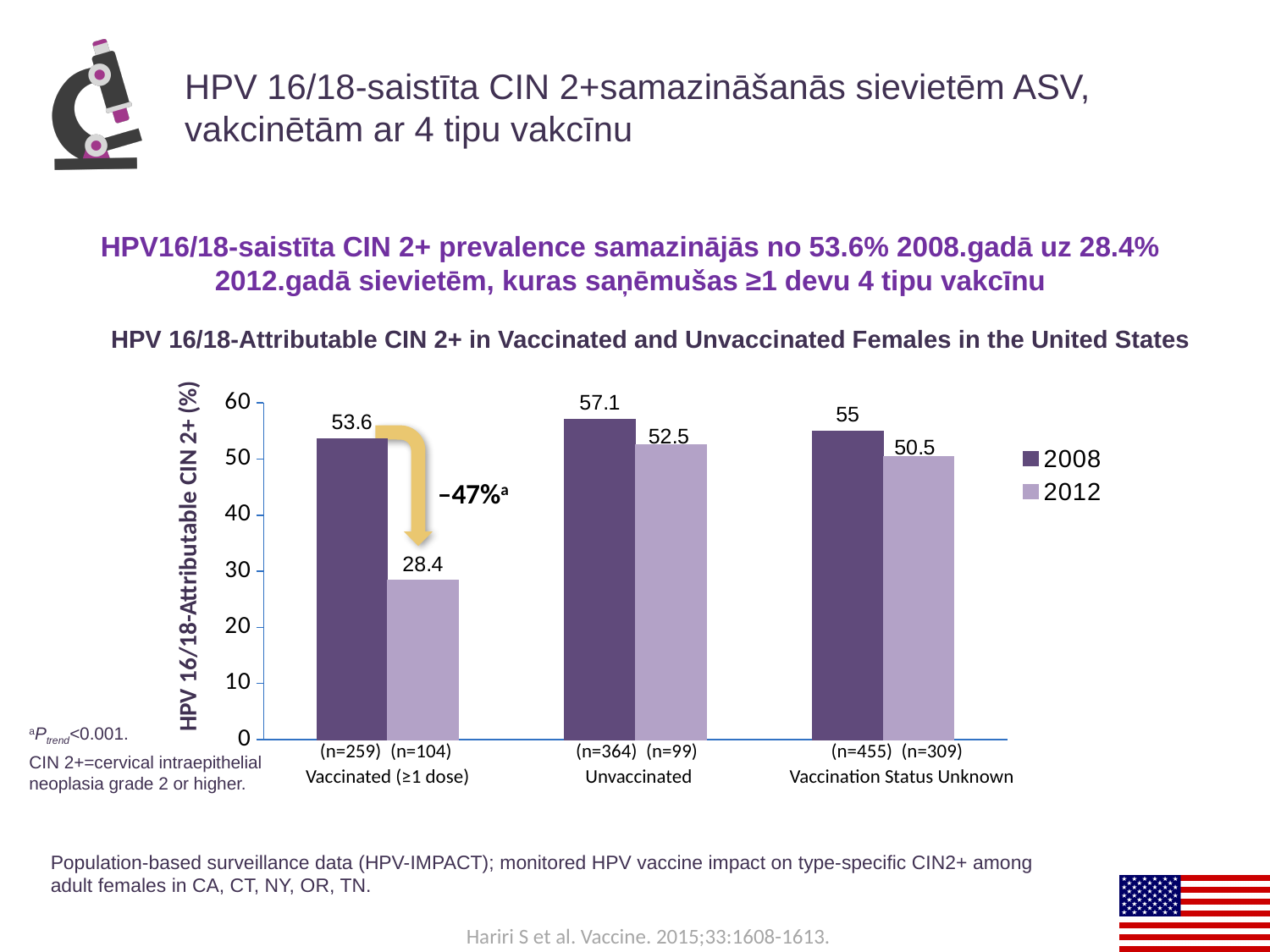
How many groups are shown on the x axis? 3 What is the difference between the 2008 and 2012 values for the Vaccinated (≥1 dose) group? 25.2 Which group has the highest 2008 value? Unvaccinated Which group has the lowest 2012 value? Vaccinated (≥1 dose) Which is larger: the 2012 value for Unvaccinated or the 2012 value for Vaccination Status Unknown? Unvaccinated What is the 2012 value for the Vaccinated (≥1 dose) group? 28.4 What is the 2008 value for the Vaccinated (≥1 dose) group? 53.6 What is the 2008 value for the Unvaccinated group? 57.1 What kind of chart is shown? Bar chart What is the difference between the 2008 and 2012 values for the Unvaccinated group? 4.6 How many series does the legend list? 2 What is the 2012 value for the Vaccination Status Unknown group? 50.5